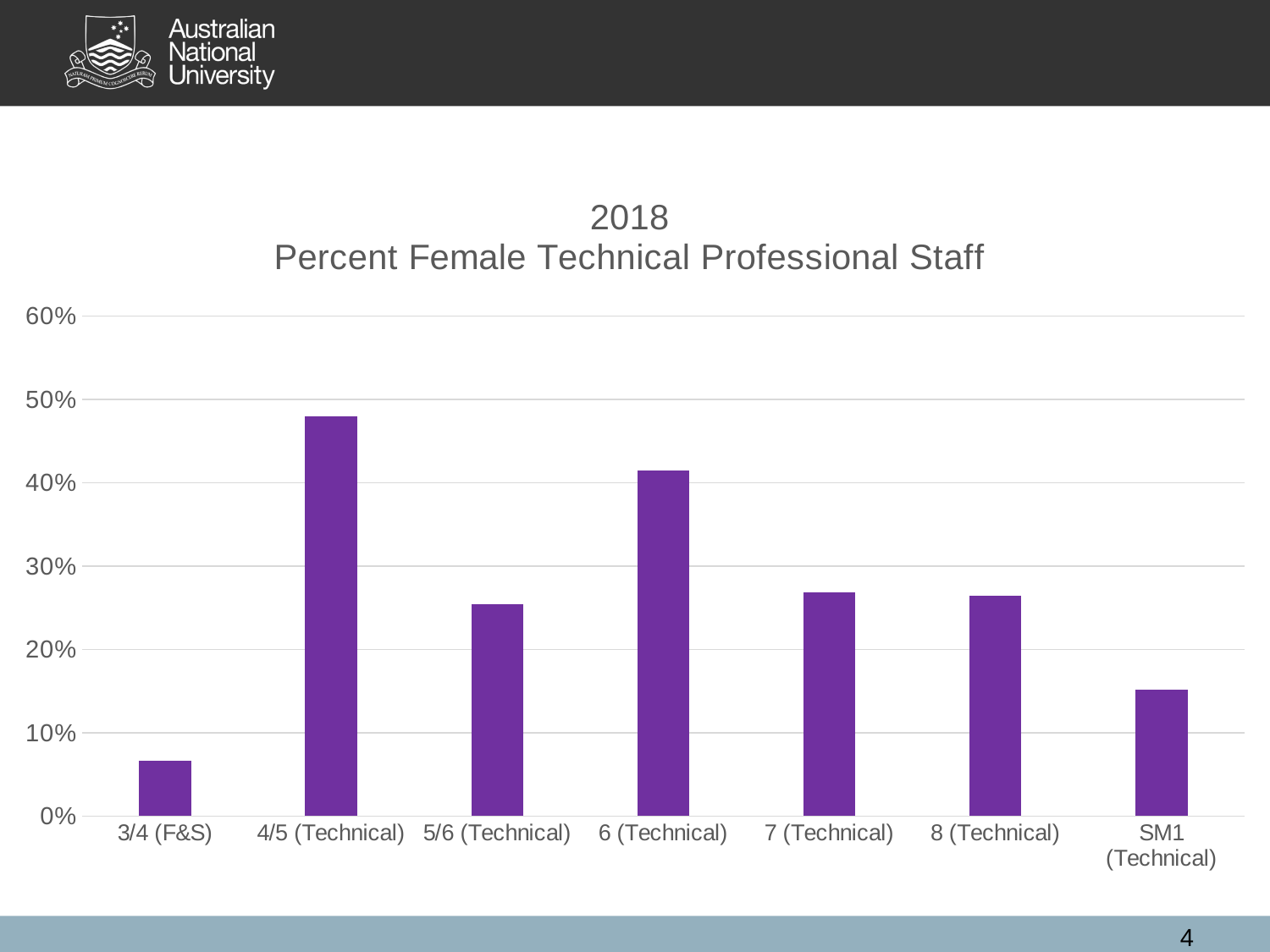
Is the value for SM1 (Technical) greater or less than 20%? less Which is larger, the value for 4/5 (Technical) or the value for 6 (Technical)? 4/5 (Technical) What is the title of the chart? 2018 Percent Female Technical Professional Staff Which category has the lowest percentage of female technical professional staff? 3/4 (F&S) Is the value for 6 (Technical) greater or less than 40%? greater Which category has the highest percentage of female technical professional staff? 4/5 (Technical) Is the value for 3/4 (F&S) greater or less than 10%? less What kind of chart is shown on the slide? bar chart How many categories are shown on the x axis of the chart? 7 Which is larger, the value for SM1 (Technical) or the value for 8 (Technical)? 8 (Technical)